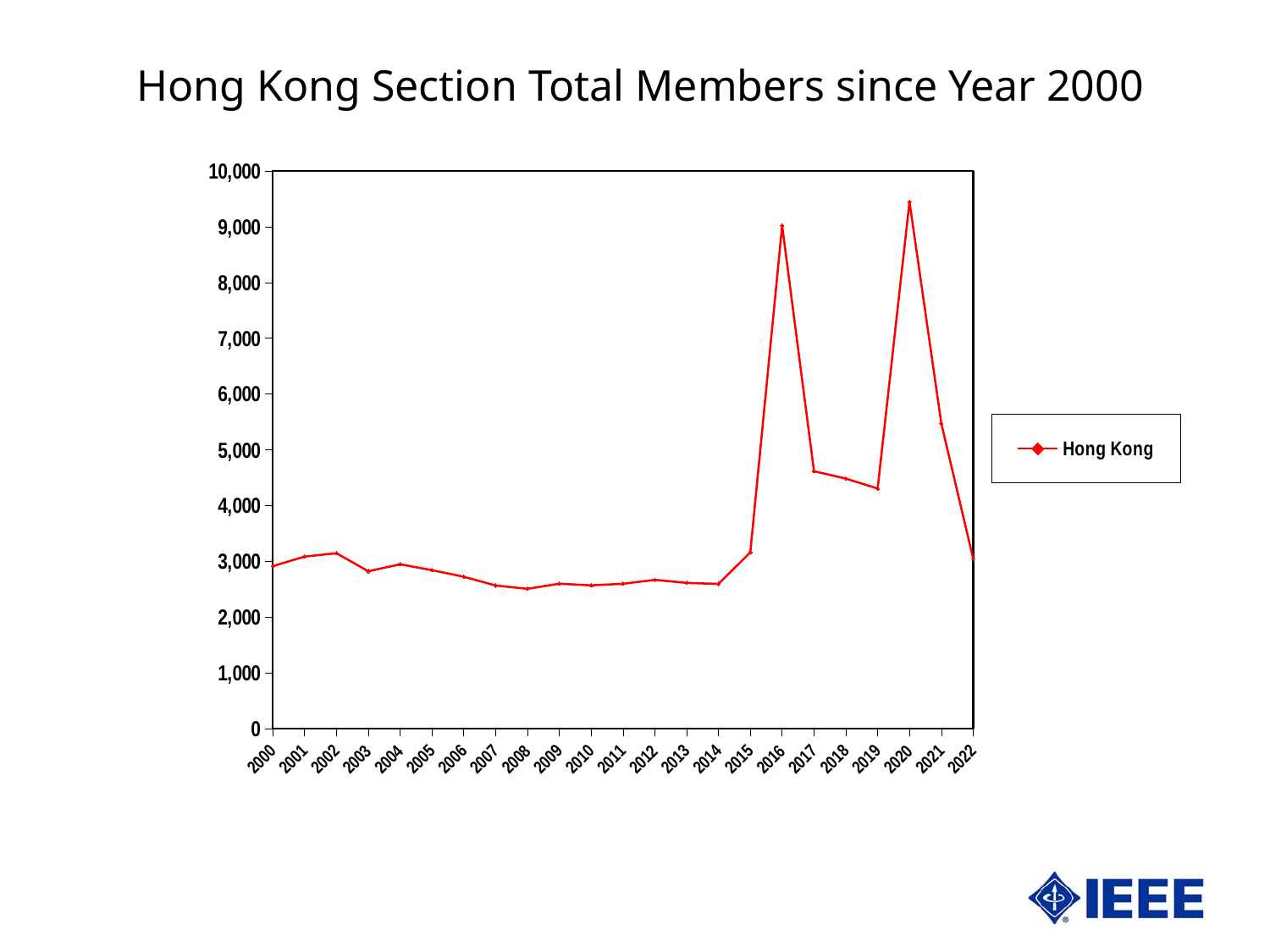
Which year has the highest number of Hong Kong Section members? 2020 Is the value for 2008 greater or less than 3,000? less How many years are plotted along the x axis? 23 Which year has the larger value, 2016 or 2017? 2016 Is the value for 2022 greater or less than 4,000? less What kind of chart is shown on the slide? line chart Is the value for 2016 greater or less than 8,000? greater Do the values rise or fall from 2020 to 2022? fall How many series does the legend list? 1 What is the name of the series shown in the legend? Hong Kong